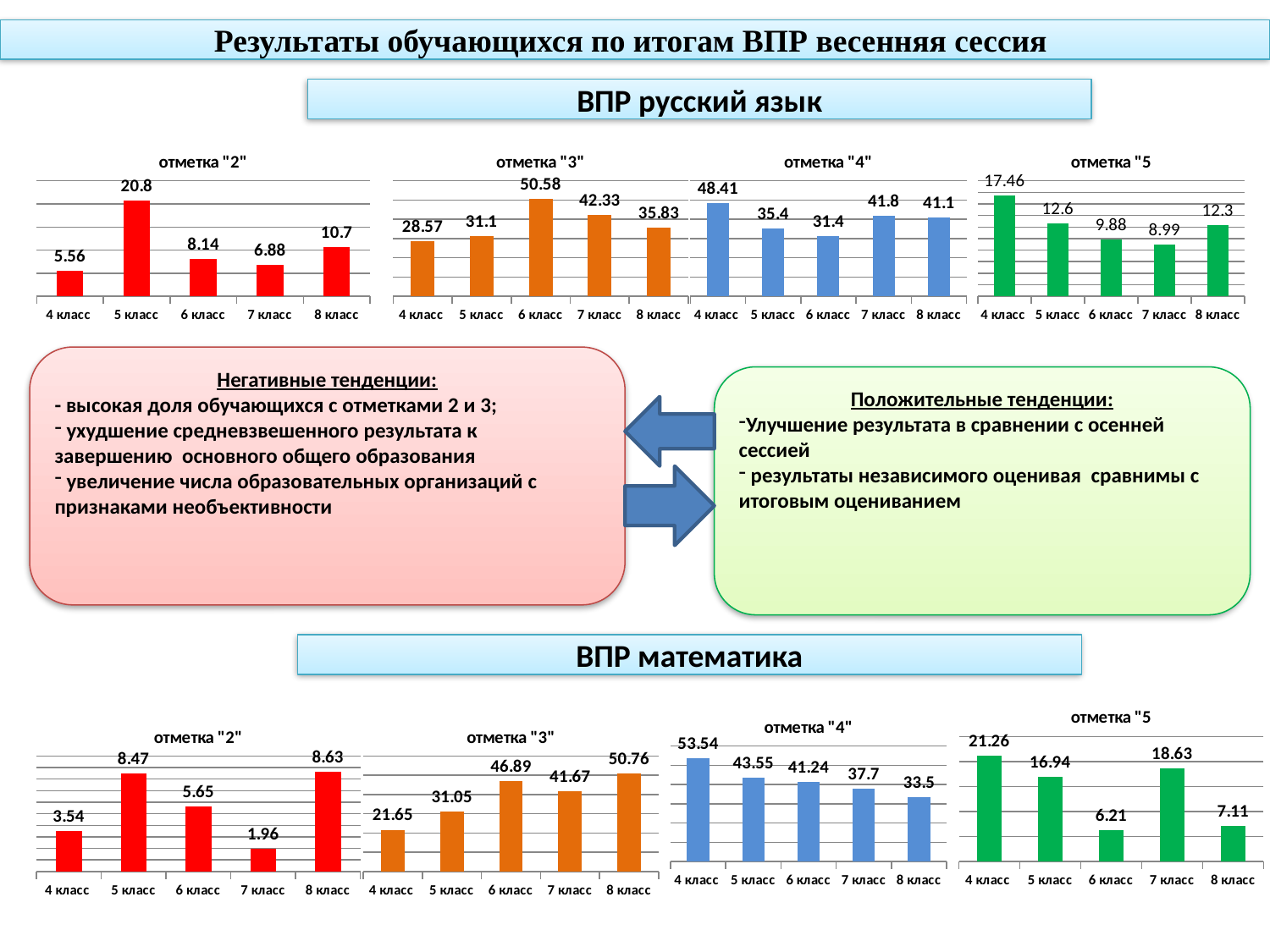
In the ВПР русский язык section, what colour are the bars on the chart titled отметка "4"? blue What type of chart is used for the отметка "2" chart in the ВПР русский язык section? bar chart In the ВПР математика section, on the chart titled отметка "2", which class has the lowest value? 7 класс In the ВПР математика section, on the chart titled отметка "5, what is the value for 7 класс? 18.63 In the ВПР русский язык section, on the chart titled отметка "5, which class has the lowest value? 7 класс In the ВПР математика section, on the chart titled отметка "2", which is larger: the value for 5 класс or for 8 класс? 8 класс In the ВПР математика section, on the chart titled отметка "4", do the values rise or fall from 4 класс to 8 класс? fall In the ВПР математика section, how many classes are shown on the chart titled отметка "3"? 5 In the ВПР русский язык section, on the chart titled отметка "3", which class has the highest value? 6 класс In the ВПР математика section, on the chart titled отметка "3", what is the difference between the values for 8 класс and 4 класс? 29.11 In the ВПР русский язык section, on the chart titled отметка "4", what is the difference between the values for 4 класс and 6 класс? 17.01 In the ВПР русский язык section, on the chart titled отметка "2", what is the value for 5 класс? 20.8